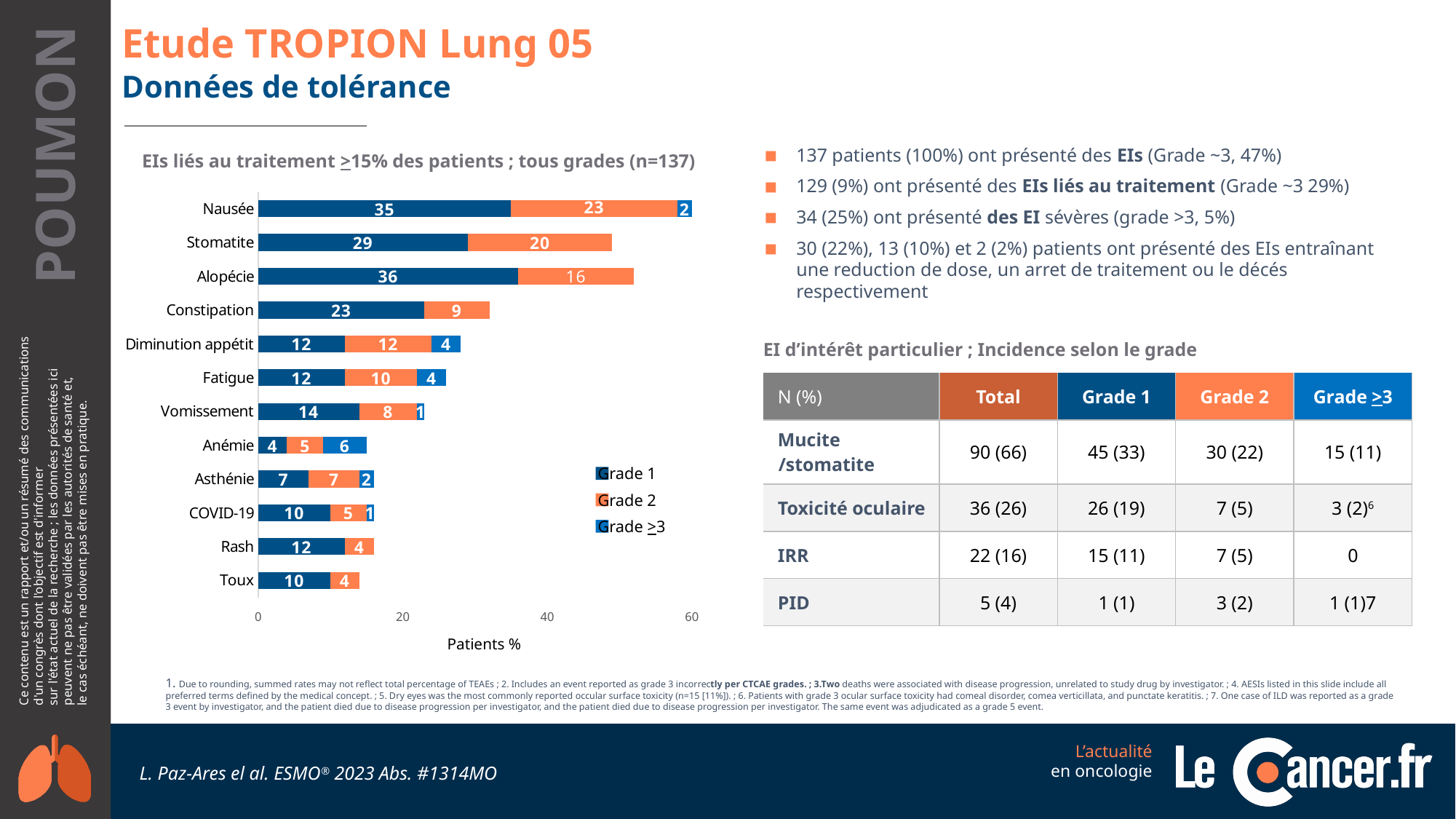
What is the Grade 2 value for Stomatite? 20 Which is larger, the Grade 1 value for Constipation or the Grade 1 value for Vomissement? Constipation How many series does the legend list? 3 What kind of chart is shown? Stacked bar chart What is the Grade ≥3 value for Anémie? 6 How many categories are shown on the chart? 12 What is the Grade 1 value for Nausée? 35 Which category has the lowest Grade 1 value? Anémie Which category has the highest Grade 1 value? Alopécie What is the difference between the Grade 2 values for Nausée and Alopécie? 7 What is the total of the stacked bar for Diminution appétit? 28 What is the total of the stacked bar for Nausée? 60